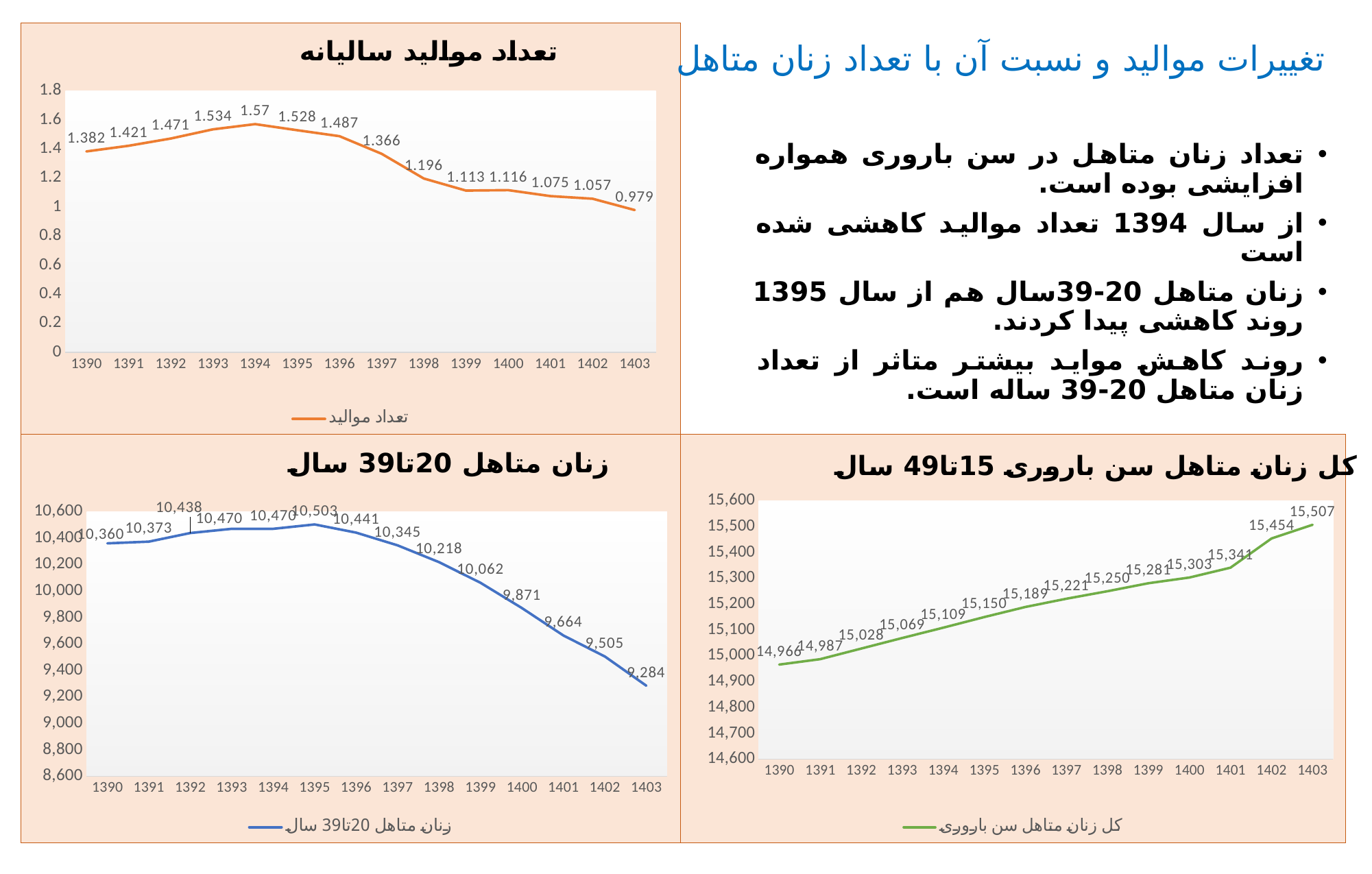
In the top-left chart titled 'تعداد موالید سالیانه', which year has the lowest value? 1403 In the bottom-left chart titled 'زنان متاهل 20تا39 سال', what is the value for 1395? 10,503 In the bottom-left chart titled 'زنان متاهل 20تا39 سال', is the value for 1400 larger or smaller than the value for 1398? smaller In the top-left chart titled 'تعداد موالید سالیانه', how many years are plotted on the x axis? 14 In the top-left chart titled 'تعداد موالید سالیانه', what is the difference between the values for 1390 and 1403? 0.403 In the bottom-left chart titled 'زنان متاهل 20تا39 سال', what is the difference between the values for 1395 and 1403? 1,219 In the bottom-right chart titled 'کل زنان متاهل سن باروری 15تا49 سال', what is the value for 1403? 15,507 In the bottom-right chart titled 'کل زنان متاهل سن باروری 15تا49 سال', do the values rise or fall from 1390 to 1403? rise What kind of chart is the bottom-right chart titled 'کل زنان متاهل سن باروری 15تا49 سال'? line chart In the bottom-right chart titled 'کل زنان متاهل سن باروری 15تا49 سال', what is the difference between the values for 1402 and 1401? 113 In the bottom-left chart titled 'زنان متاهل 20تا39 سال', which year has the highest value? 1395 In the top-left chart titled 'تعداد موالید سالیانه', what is the value for 1394? 1.57